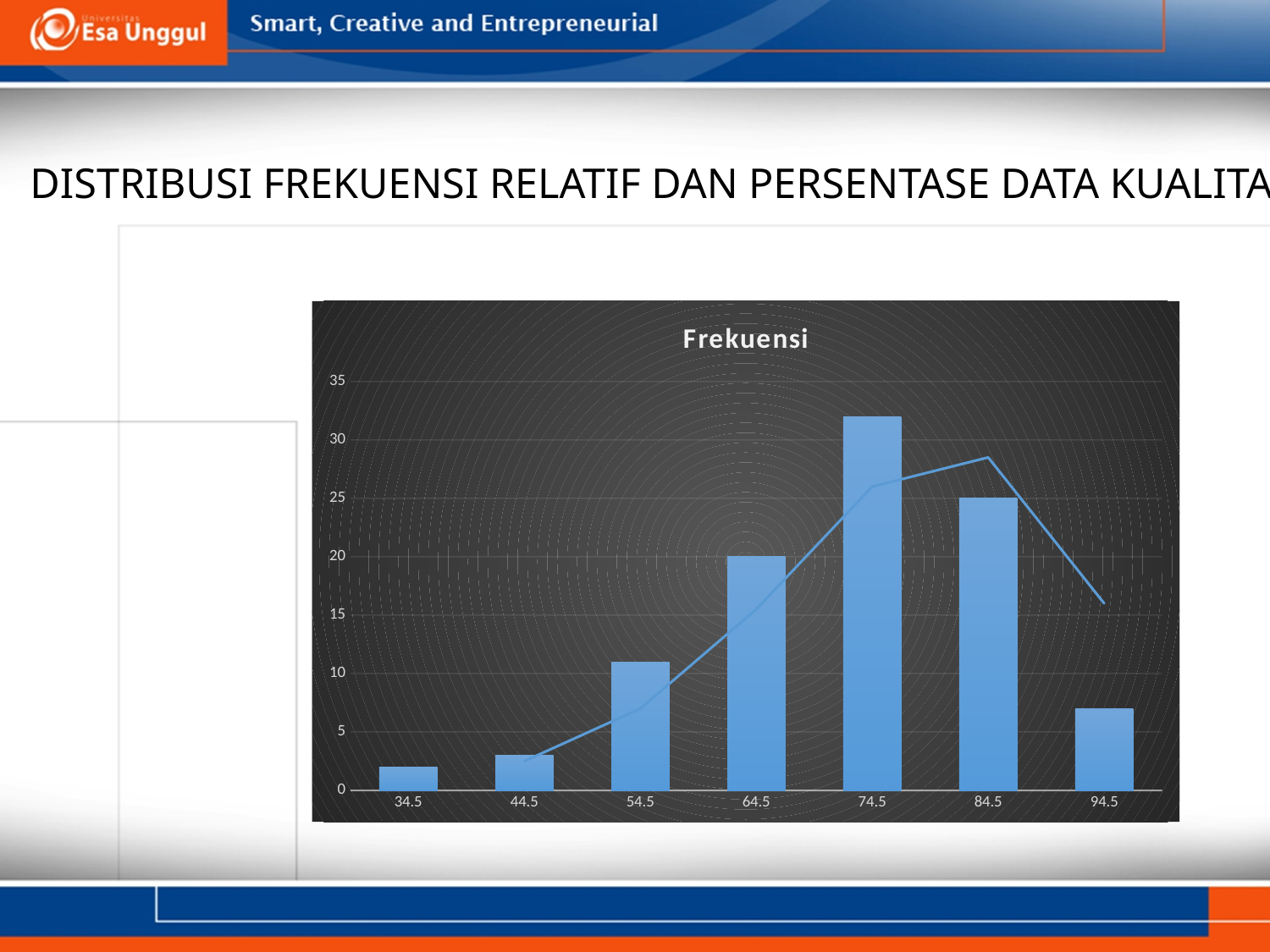
What is the difference between the bar values for 84.5 and 64.5? 5 How many categories are shown on the x axis of the chart? 7 What is the title of the chart? Frekuensi Do the bar values rise or fall from 34.5 to 74.5? rise What is the value of the bar for 84.5? 25 Is the value for 34.5 greater or less than 5? less Is the value for 94.5 greater or less than 5? greater Which bar is taller, 74.5 or 84.5? 74.5 Is the value for 74.5 greater or less than 30? greater What kind of chart is shown on the slide? bar chart What is the value of the bar for 64.5? 20 Which category has the highest bar in the chart? 74.5